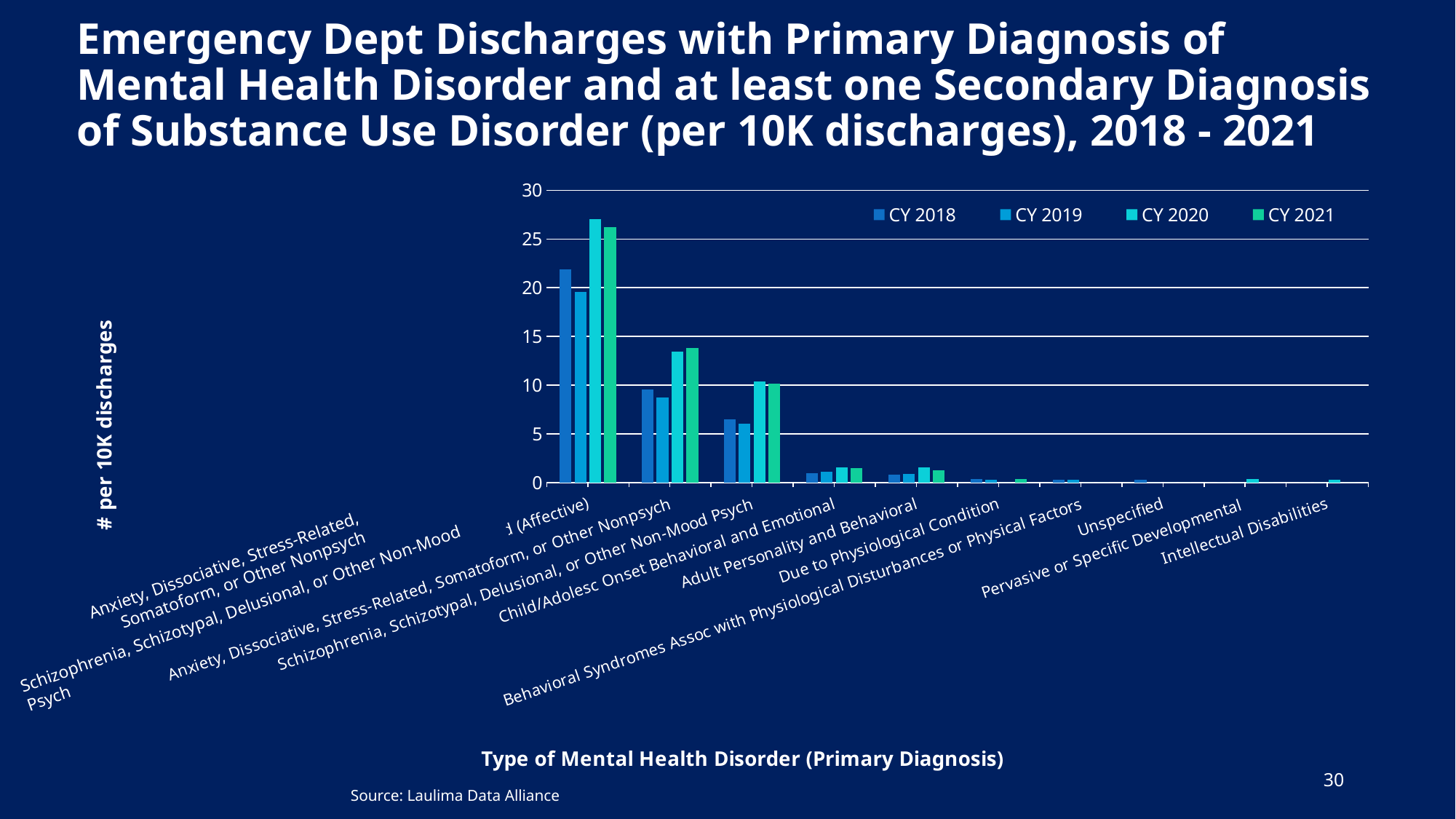
What source is cited for the chart? Laulima Data Alliance Is the CY 2020 value for Anxiety, Dissociative, Stress-Related, Somatoform, or Other Nonpsych greater or less than 10? greater Is the CY 2018 value for Schizophrenia, Schizotypal, Delusional, or Other Non-Mood Psych greater or less than 5? greater How many series does the legend list? 4 For Schizophrenia, Schizotypal, Delusional, or Other Non-Mood Psych, which is larger: the CY 2019 value or the CY 2021 value? CY 2021 For Anxiety, Dissociative, Stress-Related, Somatoform, or Other Nonpsych, which is larger: the CY 2018 value or the CY 2020 value? CY 2020 What kind of chart is shown on the slide? bar chart Is the CY 2021 value for Child/Adolesc Onset Behavioral and Emotional greater or less than 5? less How many categories of mental health disorder are plotted along the x axis? 10 What is the title of the y axis? # per 10K discharges